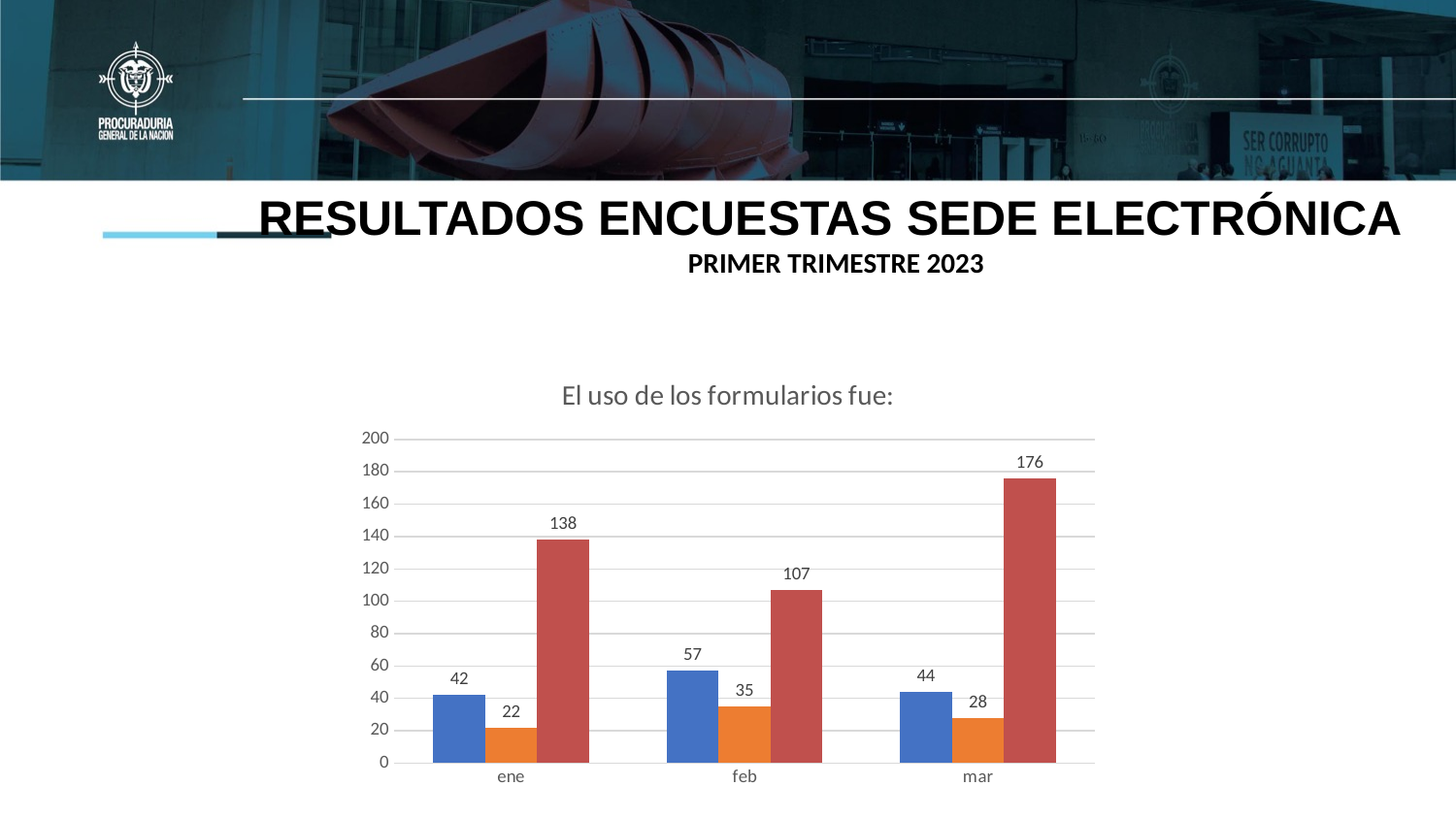
Do the values of the blue bars rise or fall from feb to mar? fall What is the title of the chart? El uso de los formularios fue: What is the difference between the red bar for mar and the red bar for feb? 69 What is the difference between the blue bar and the orange bar for feb? 22 What kind of chart is shown on the slide? bar chart Which month has the lowest orange bar? ene How many months are shown on the x axis? 3 What is the value of the orange bar for ene? 22 What is the value of the red bar for mar? 176 Which month has the highest red bar? mar Which is larger, the blue bar for ene or the blue bar for mar? the blue bar for mar What is the value of the blue bar for feb? 57